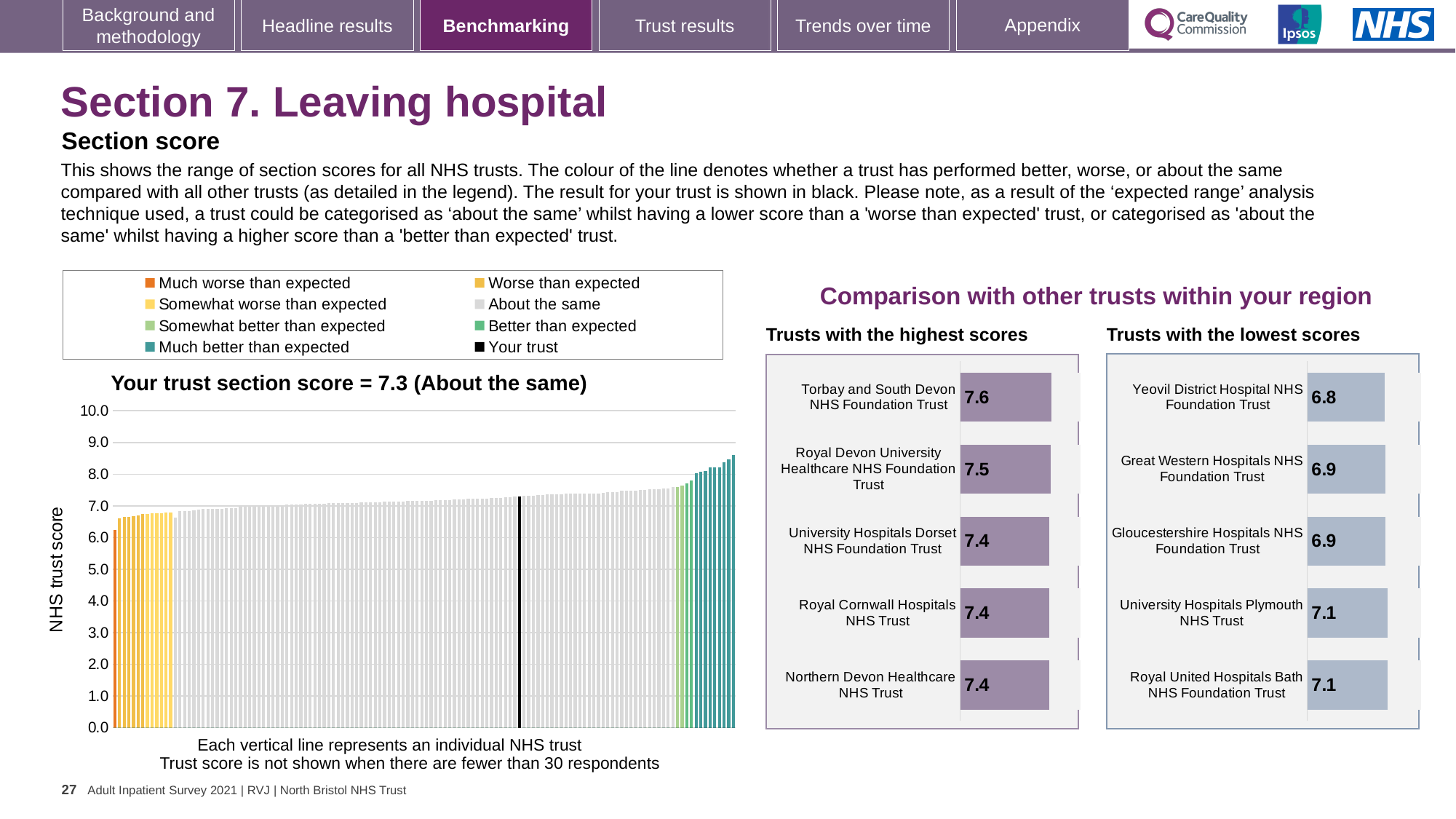
In the 'Trusts with the lowest scores' chart, what is the score for University Hospitals Plymouth NHS Trust? 7.1 In the 'Trusts with the highest scores' chart, what is the score for Royal Devon University Healthcare NHS Foundation Trust? 7.5 In the 'Trusts with the lowest scores' chart, what is the difference between the scores of Royal United Hospitals Bath NHS Foundation Trust and Yeovil District Hospital NHS Foundation Trust? 0.3 In the 'Trusts with the highest scores' chart, what is the score for Torbay and South Devon NHS Foundation Trust? 7.6 In the 'Trusts with the lowest scores' chart, which trust has the lowest score? Yeovil District Hospital NHS Foundation Trust In the main chart on the left, what is your trust's section score? 7.3 In the 'Trusts with the highest scores' chart, which trust has the highest score? Torbay and South Devon NHS Foundation Trust What kind of chart is the main chart on the left showing the range of section scores for all NHS trusts? Bar chart Which is larger: the score for Torbay and South Devon NHS Foundation Trust in the highest scores chart, or the score for Great Western Hospitals NHS Foundation Trust in the lowest scores chart? Torbay and South Devon NHS Foundation Trust How many trusts are shown in the 'Trusts with the highest scores' chart? 5 In the 'Trusts with the lowest scores' chart, what is the score for Yeovil District Hospital NHS Foundation Trust? 6.8 In the main chart on the left, do the trust scores rise or fall from left to right along the x axis? Rise